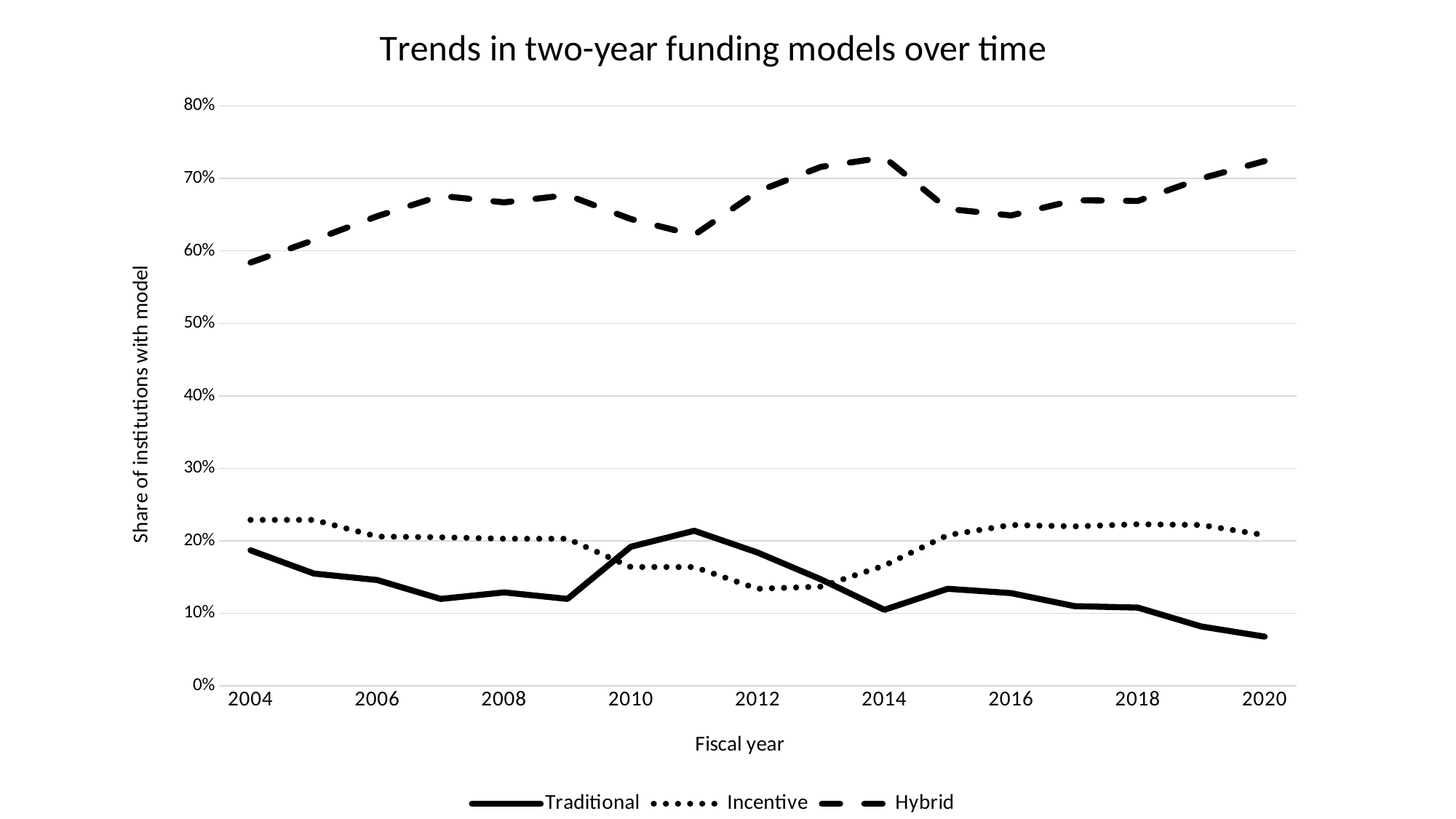
Is the value for Incentive in 2004 greater or less than 20%? greater In 2011, which is larger: Traditional or Incentive? Traditional How many fiscal years are plotted along the x axis, from 2004 to 2020? 17 In which year is the Traditional series at its lowest? 2020 Does the Traditional series rise or fall from 2015 to 2020? fall Which series has the highest share of institutions across all years? Hybrid Is the value for Hybrid in 2014 greater or less than 70%? greater What kind of chart is shown on the slide? line chart Is the value for Traditional in 2020 greater or less than 10%? less What is the title of the chart? Trends in two-year funding models over time How many series does the legend list? 3